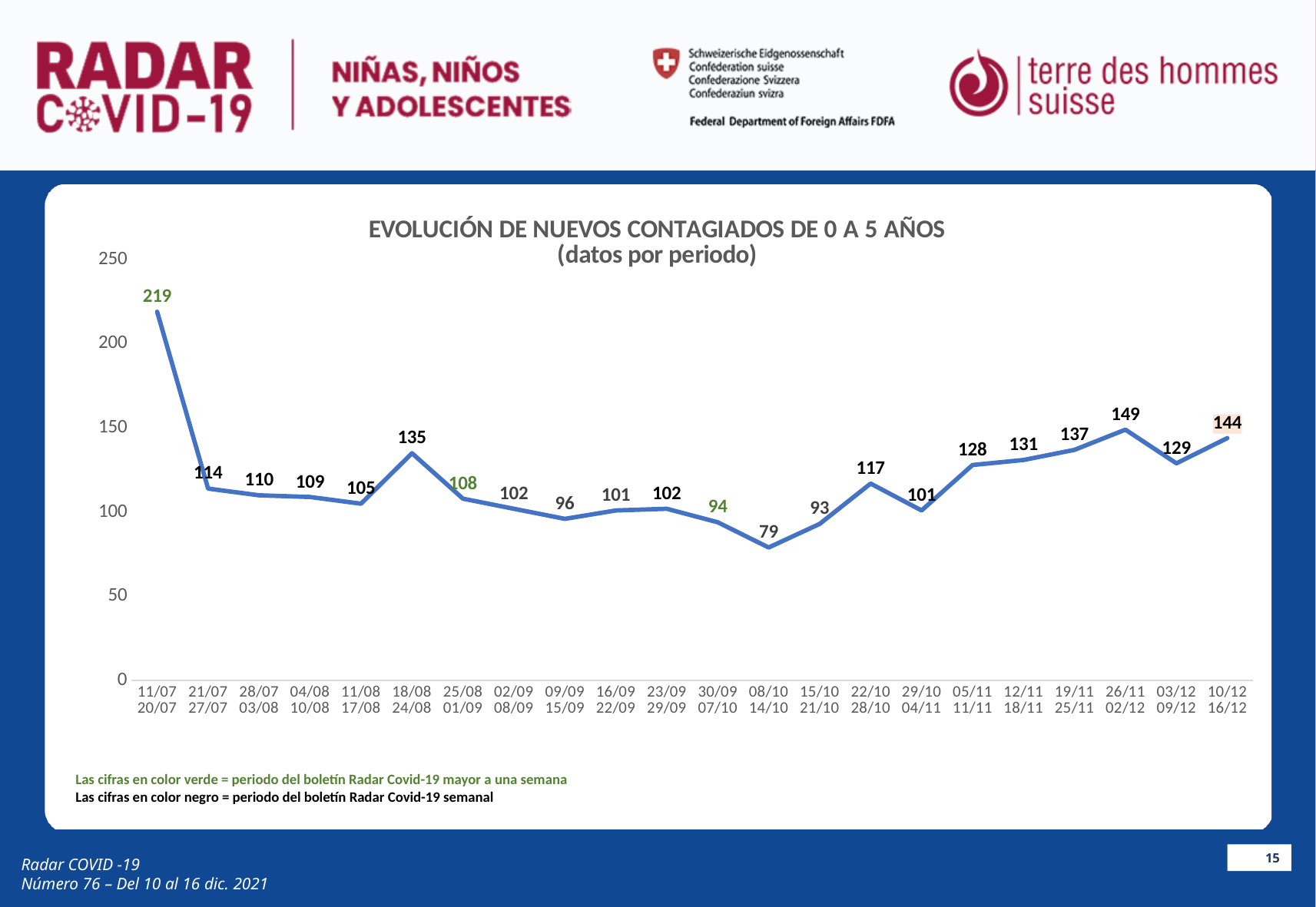
How many periods (data points) are plotted on the chart? 22 What is the difference between the values for 26/11–02/12 and 03/12–09/12? 20 What type of chart is shown on the slide? line chart What is the value for the period 11/07–20/07? 219 What is the title of the chart? EVOLUCIÓN DE NUEVOS CONTAGIADOS DE 0 A 5 AÑOS (datos por periodo) What is the value for the period 08/10–14/10? 79 Which period has the lowest value? 08/10–14/10 Which period has the highest value? 11/07–20/07 Which is larger, the value for 22/10–28/10 or the value for 29/10–04/11? 22/10–28/10 What is the value for the last period, 10/12–16/12? 144 Do the values rise or fall from 08/10–14/10 to 26/11–02/12? rise What is the value for the period 18/08–24/08? 135